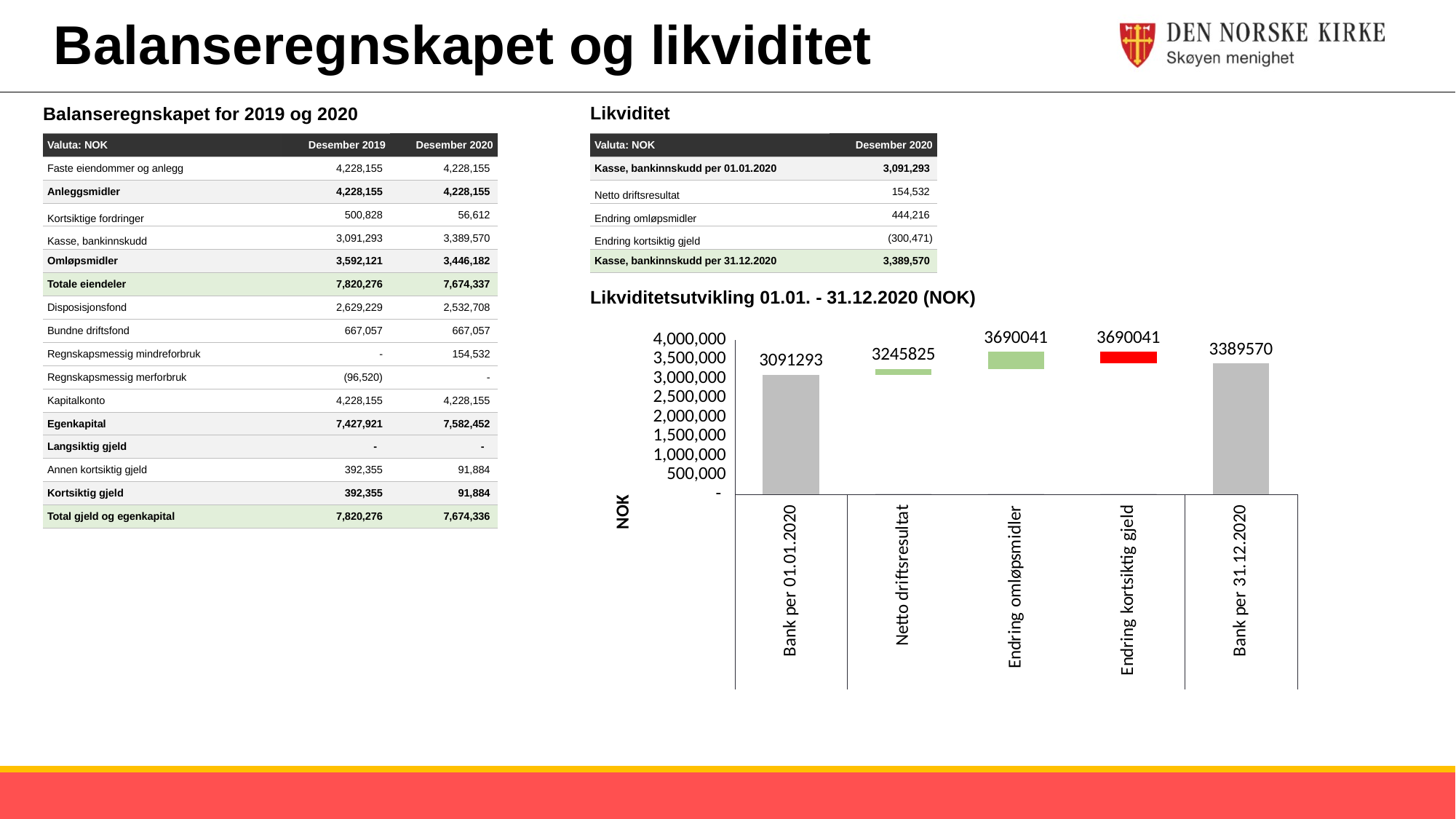
In the Likviditetsutvikling chart, is the value for 'Bank per 31.12.2020' greater or less than 3,500,000? less In the Likviditetsutvikling chart, what is the difference between the labelled values for 'Bank per 31.12.2020' and 'Bank per 01.01.2020'? 298277 In the Likviditetsutvikling chart, what value is labelled for 'Bank per 01.01.2020'? 3091293 In the Likviditetsutvikling chart, which is larger: the value for 'Bank per 01.01.2020' or 'Bank per 31.12.2020'? Bank per 31.12.2020 In the Likviditetsutvikling chart, is the value for 'Bank per 01.01.2020' greater or less than 3,000,000? greater What type of chart is shown under 'Likviditetsutvikling 01.01. - 31.12.2020 (NOK)'? Bar chart In the Likviditetsutvikling chart, what data label is shown above the 'Endring omløpsmidler' bar? 3690041 In the Likviditetsutvikling chart, what data label is shown above the 'Netto driftsresultat' bar? 3245825 How many categories are shown on the x axis of the Likviditetsutvikling chart? 5 In the Likviditetsutvikling chart, what colour is the bar for 'Endring kortsiktig gjeld'? Red In the Likviditetsutvikling chart, what value is labelled for 'Bank per 31.12.2020'? 3389570 What is the y-axis title of the Likviditetsutvikling chart? NOK